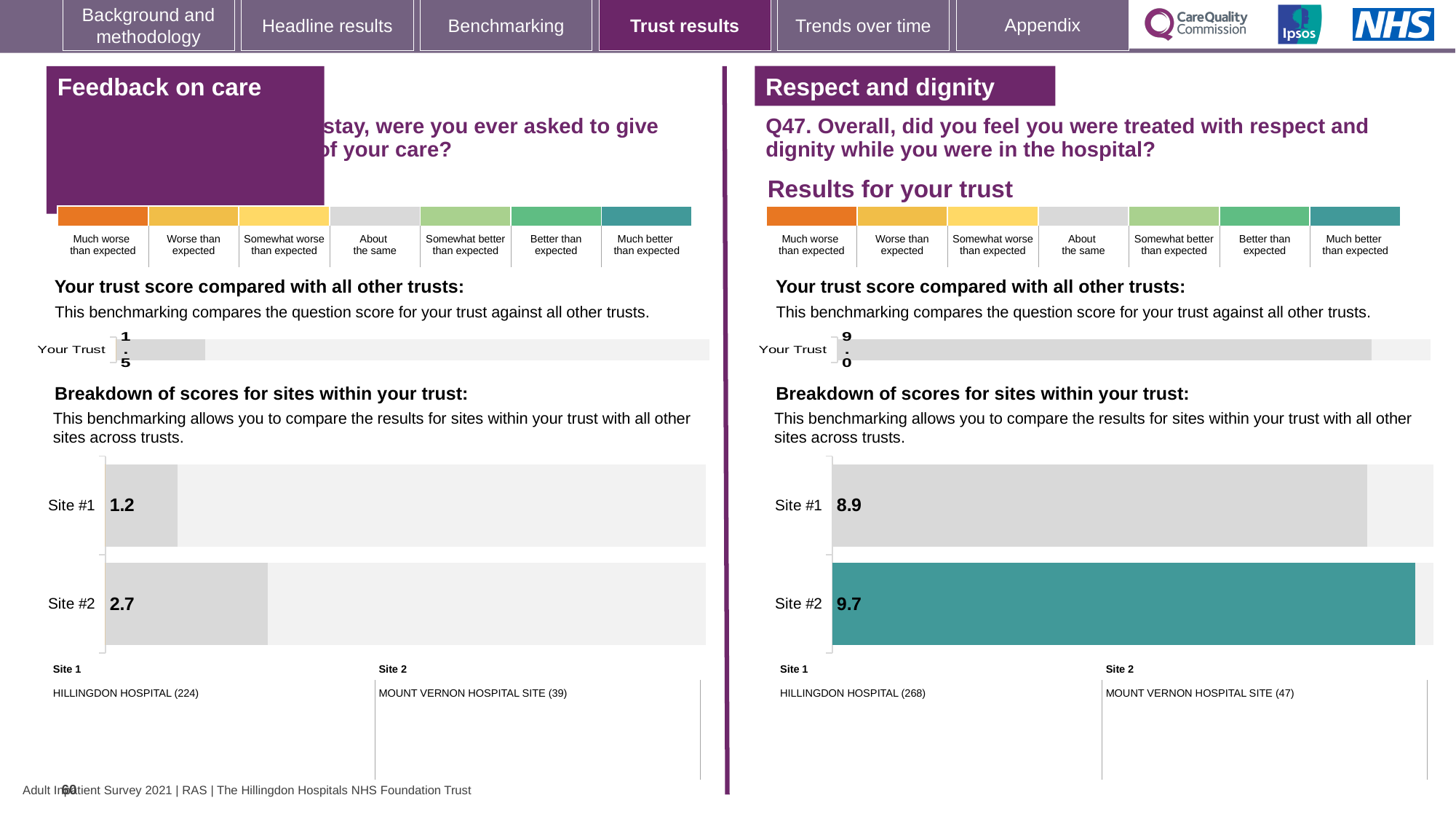
On the 'Feedback on care' panel, in the 'Breakdown of scores for sites within your trust' chart, what is the score for Site #1? 1.2 What type of chart is used for the 'Breakdown of scores for sites within your trust' on the 'Feedback on care' panel? Bar chart On the 'Respect and dignity' panel, in the 'Breakdown of scores for sites within your trust' chart, what is the score for Site #1? 8.9 On the 'Respect and dignity' panel, what is the 'Your Trust' score shown in the 'Your trust score compared with all other trusts' chart? 9.0 On the 'Respect and dignity' panel, in the 'Breakdown of scores for sites within your trust' chart, what is the score for Site #2? 9.7 On the 'Feedback on care' panel, in the site breakdown chart, what is the difference between the Site #2 and Site #1 scores? 1.5 On the 'Respect and dignity' panel, in the site breakdown chart, what is the difference between the Site #2 and Site #1 scores? 0.8 On the 'Feedback on care' panel, in the 'Breakdown of scores for sites within your trust' chart, what is the score for Site #2? 2.7 On the 'Respect and dignity' panel, in the site breakdown chart, which site has the lower score? Site #1 On the 'Feedback on care' panel, in the site breakdown chart, which site has the higher score? Site #2 On the 'Respect and dignity' panel, how many sites are shown in the 'Breakdown of scores for sites within your trust' chart? 2 On the 'Feedback on care' panel, what is the 'Your Trust' score shown in the 'Your trust score compared with all other trusts' chart? 1.5